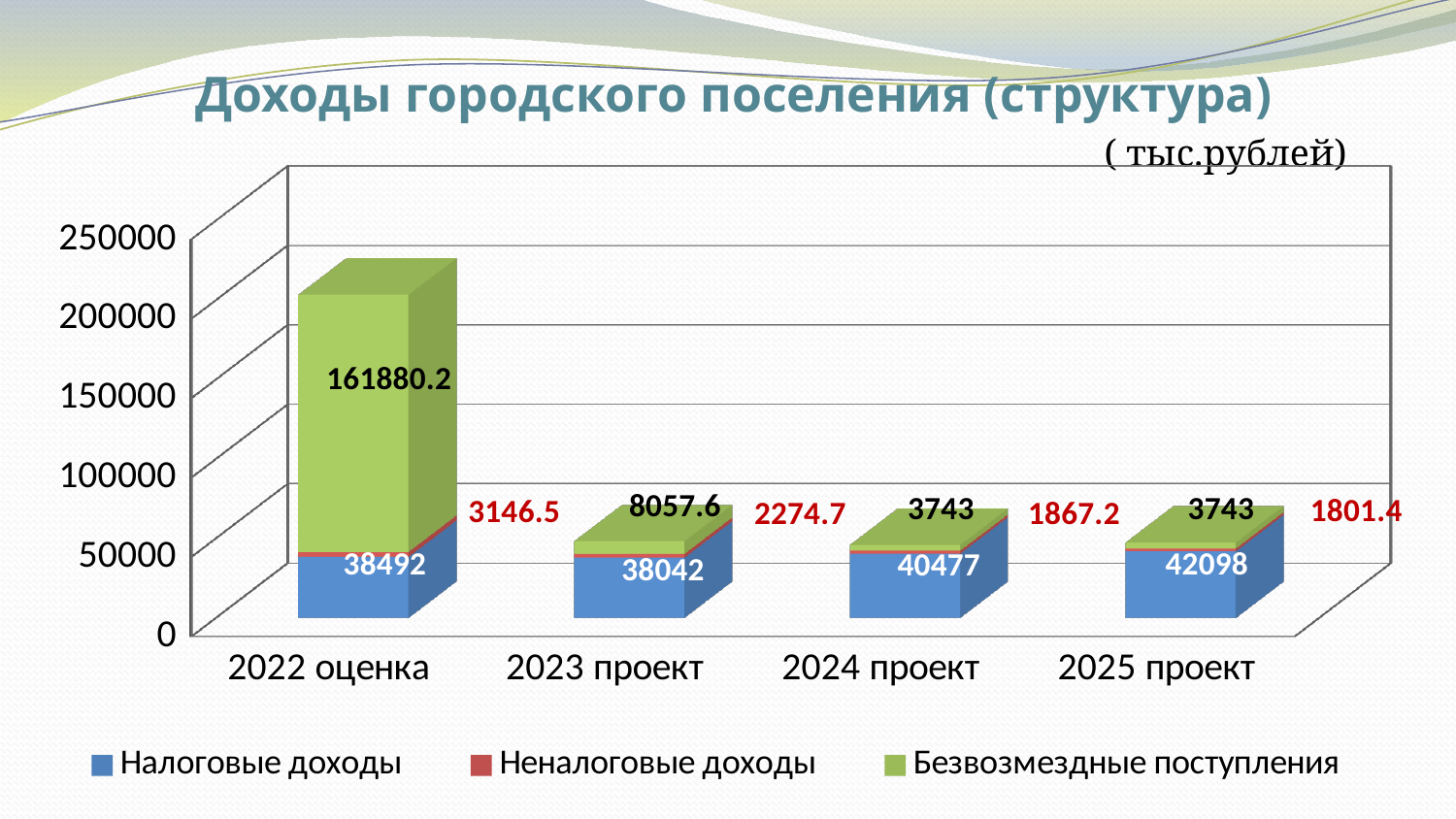
What is the difference between Налоговые доходы for 2025 проект and 2024 проект? 1621 Which category has the lowest value of Неналоговые доходы? 2025 проект How many series does the legend list? 3 Which is larger: Безвозмездные поступления for 2023 проект or for 2024 проект? 2023 проект What is the value of Неналоговые доходы for 2023 проект? 2274.7 What is the value of Безвозмездные поступления for 2022 оценка? 161880.2 What is the value of Налоговые доходы for 2025 проект? 42098 What is the value of Налоговые доходы for 2022 оценка? 38492 What is the total of the stacked bar for 2024 проект? 46087.2 How many categories are shown on the x axis? 4 Which category has the highest value of Безвозмездные поступления? 2022 оценка What kind of chart is shown on the slide? Stacked bar chart